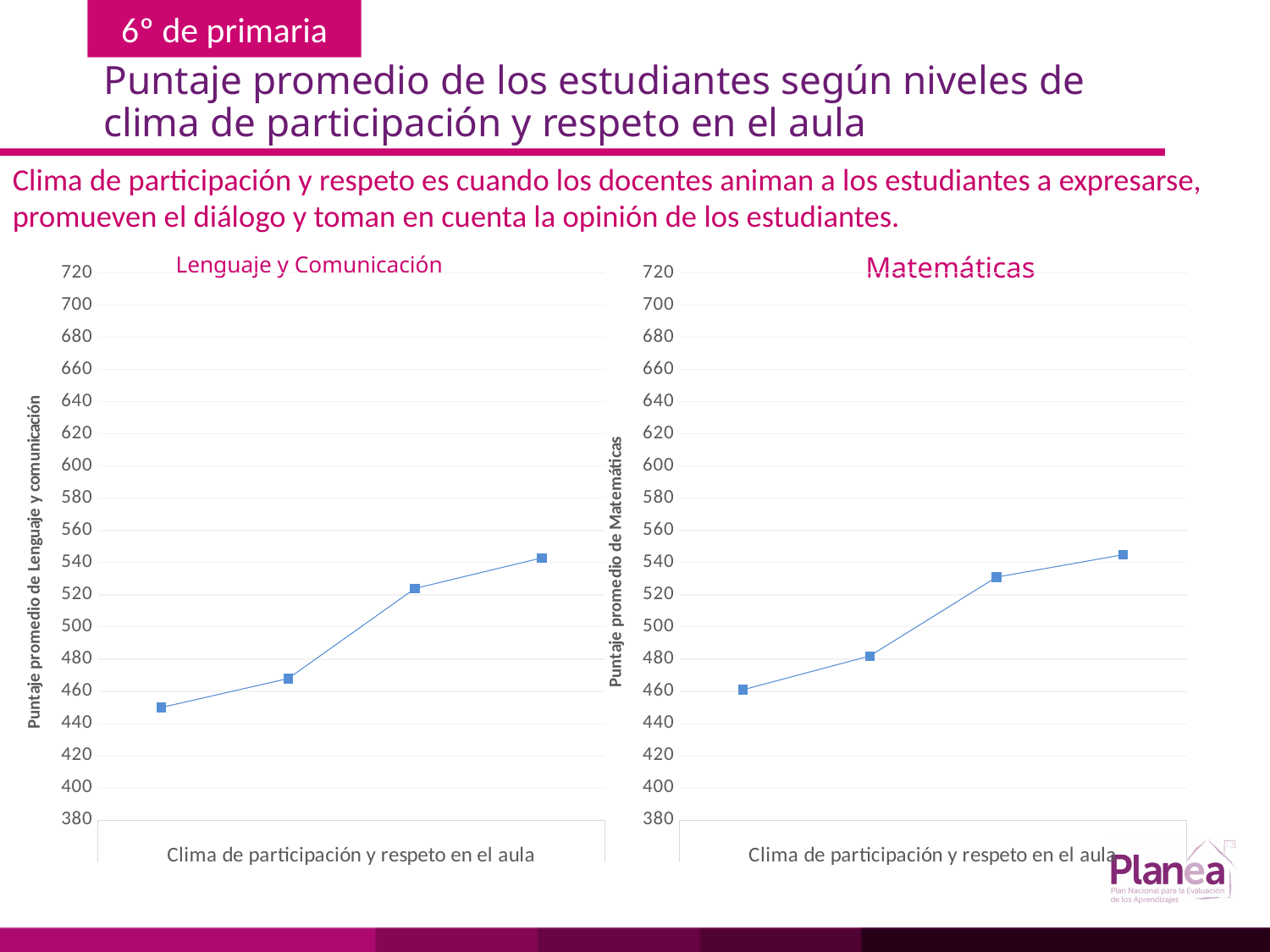
In the "Lenguaje y Comunicación" chart, is the value of the rightmost point greater or less than 520? greater In the "Lenguaje y Comunicación" chart, which point has the highest value, the leftmost or the rightmost? the rightmost What is the x-axis title of the "Lenguaje y Comunicación" chart? Clima de participación y respeto en el aula In the "Matemáticas" chart, do the values rise or fall from left to right along the x axis? rise What is the y-axis title of the "Matemáticas" chart? Puntaje promedio de Matemáticas What kind of chart is the "Lenguaje y Comunicación" chart? line chart In the "Matemáticas" chart, is the value of the second point from the left greater or less than 500? less In the "Matemáticas" chart, is the value of the rightmost point greater or less than 520? greater How many data points are plotted in the "Matemáticas" chart? 4 In the "Lenguaje y Comunicación" chart, do the values rise or fall from left to right along the x axis? rise